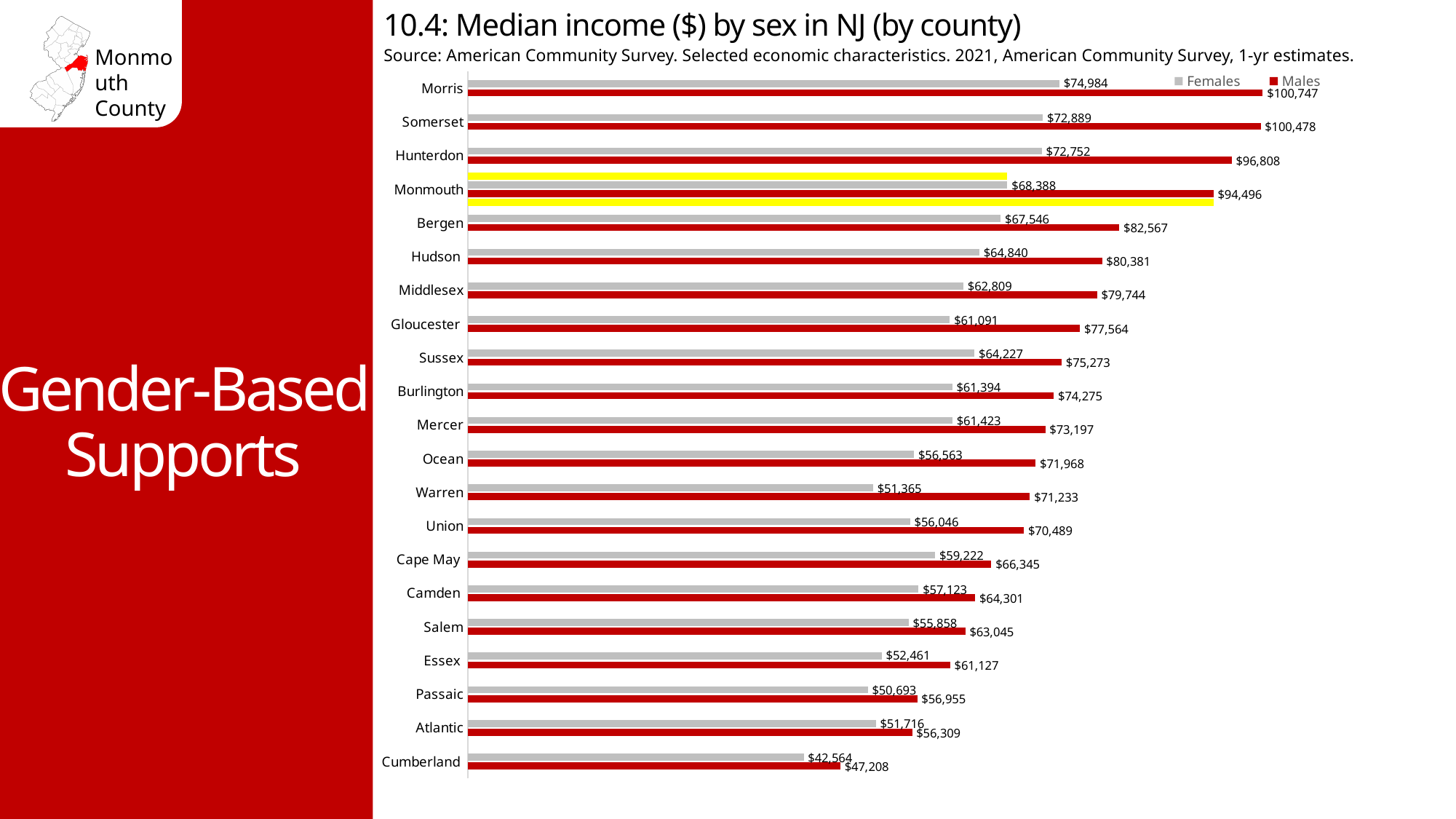
What kind of chart is shown on the slide? Bar chart Which county's bars are highlighted in yellow on the chart? Monmouth How many counties are shown in the chart? 21 What is the median income for males in Monmouth County? $94,496 What is the median income for females in Cumberland County? $42,564 What is the median income for females in Bergen County? $67,546 What is the difference between male and female median income in Monmouth County? $26,108 Which county has the lowest median income for females? Cumberland What is the difference between male and female median income in Cumberland County? $4,644 Which is larger, the female median income in Sussex County or in Gloucester County? Sussex How many series does the legend list? 2 Which county has the highest median income for males? Morris